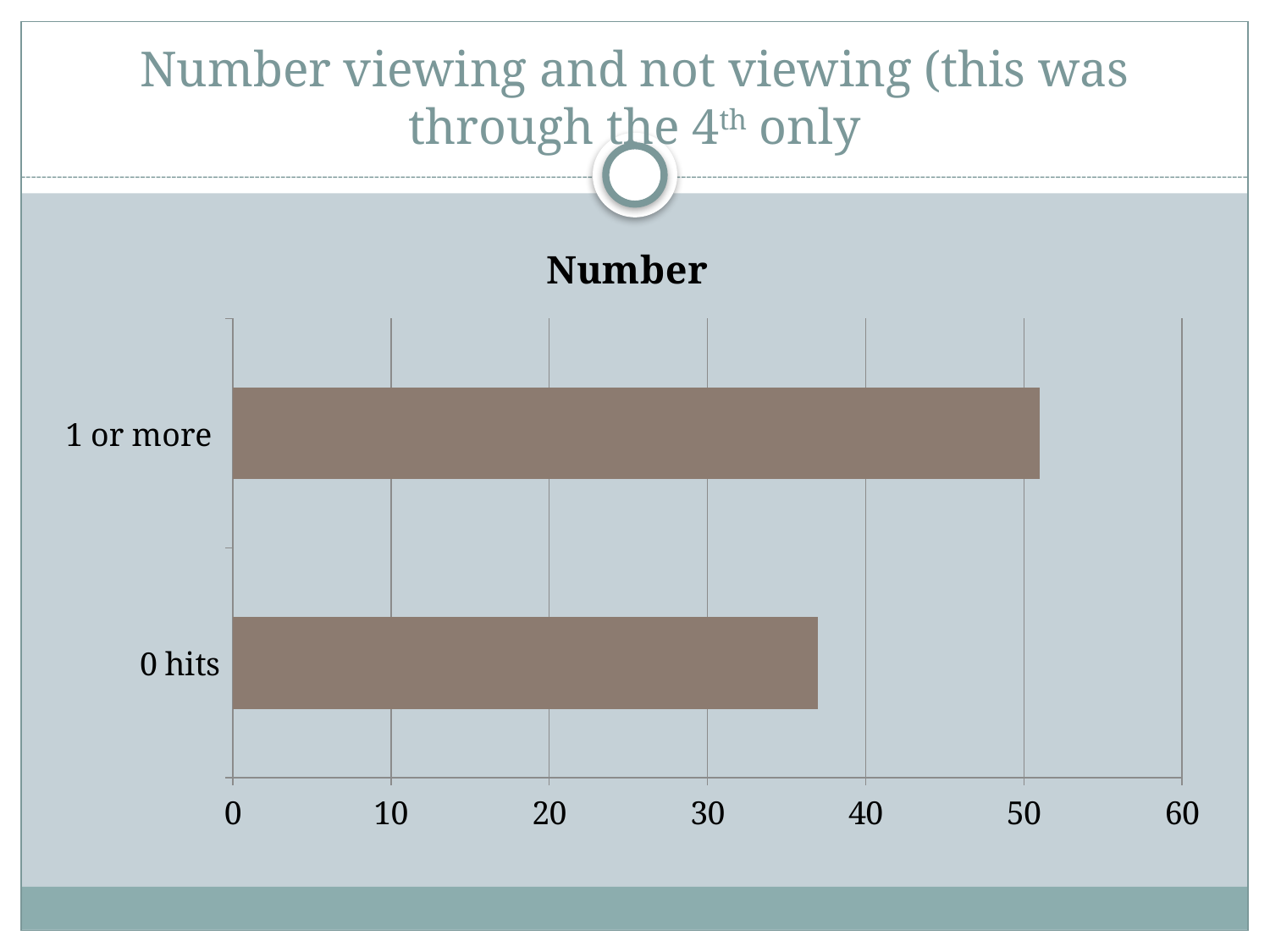
Which is larger, the value for "1 or more" or the value for "0 hits"? 1 or more How many categories are plotted in the chart? 2 Is the value for "0 hits" greater or less than 30? greater Which category has the highest value in the chart? 1 or more What kind of chart is shown on the slide? bar chart What is the highest value shown on the horizontal axis of the chart? 60 What is the title shown above the chart? Number Is the value for "1 or more" greater or less than 40? greater Which category has the lowest value in the chart? 0 hits Is the value for "0 hits" greater or less than 40? less